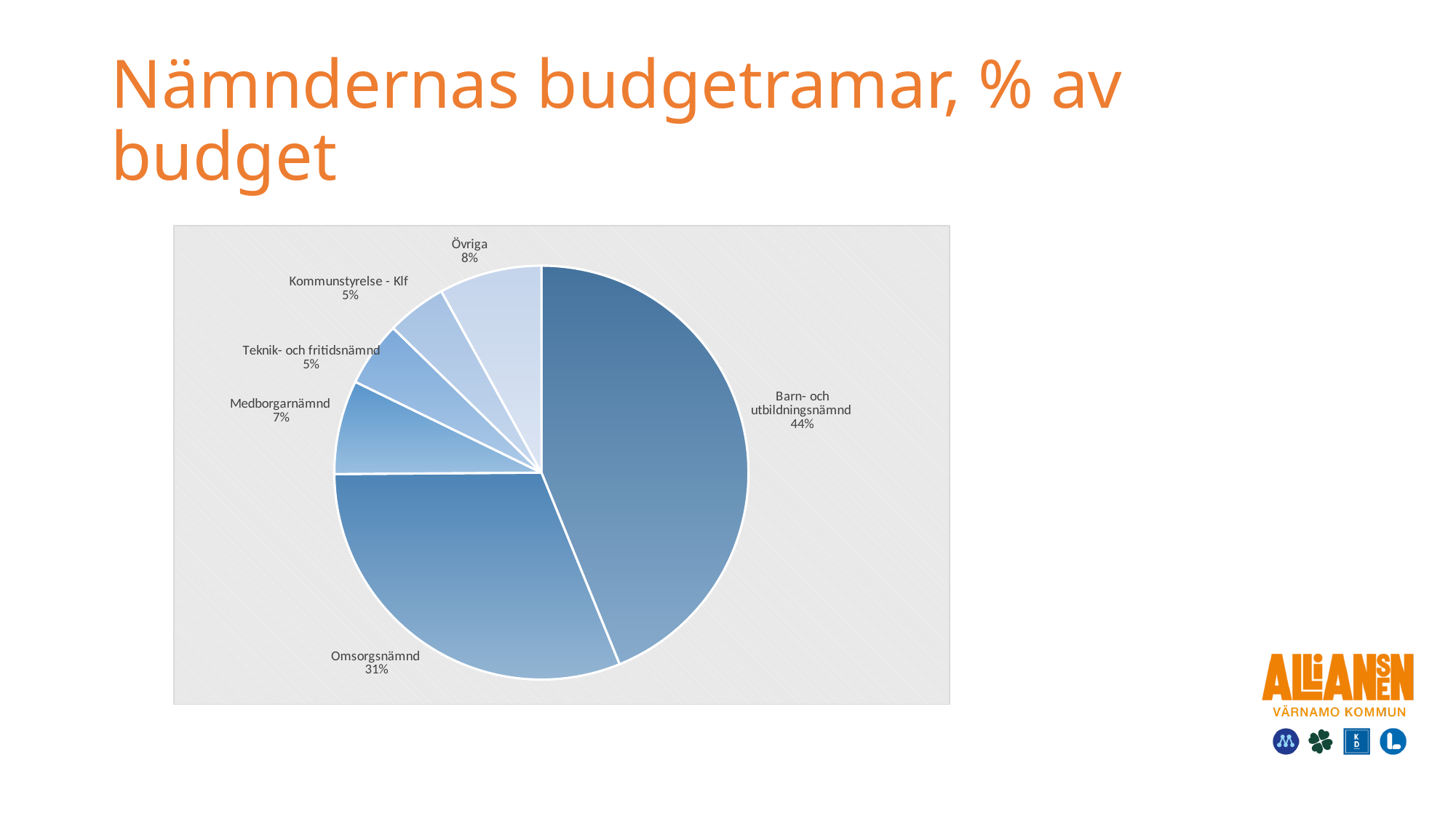
Which is larger, the share for Övriga or the share for Medborgarnämnd? Övriga What share of the budget does Kommunstyrelse - Klf have? 5% What is the combined share of Barn- och utbildningsnämnd and Omsorgsnämnd? 75% What share of the budget does Medborgarnämnd have? 7% What is the title of the slide? Nämndernas budgetramar, % av budget What kind of chart is shown on the slide? pie chart What share of the budget does Omsorgsnämnd have? 31% How many slices does the pie chart have? 6 Which category has the largest share of the budget? Barn- och utbildningsnämnd What is the difference in percentage points between Barn- och utbildningsnämnd and Omsorgsnämnd? 13